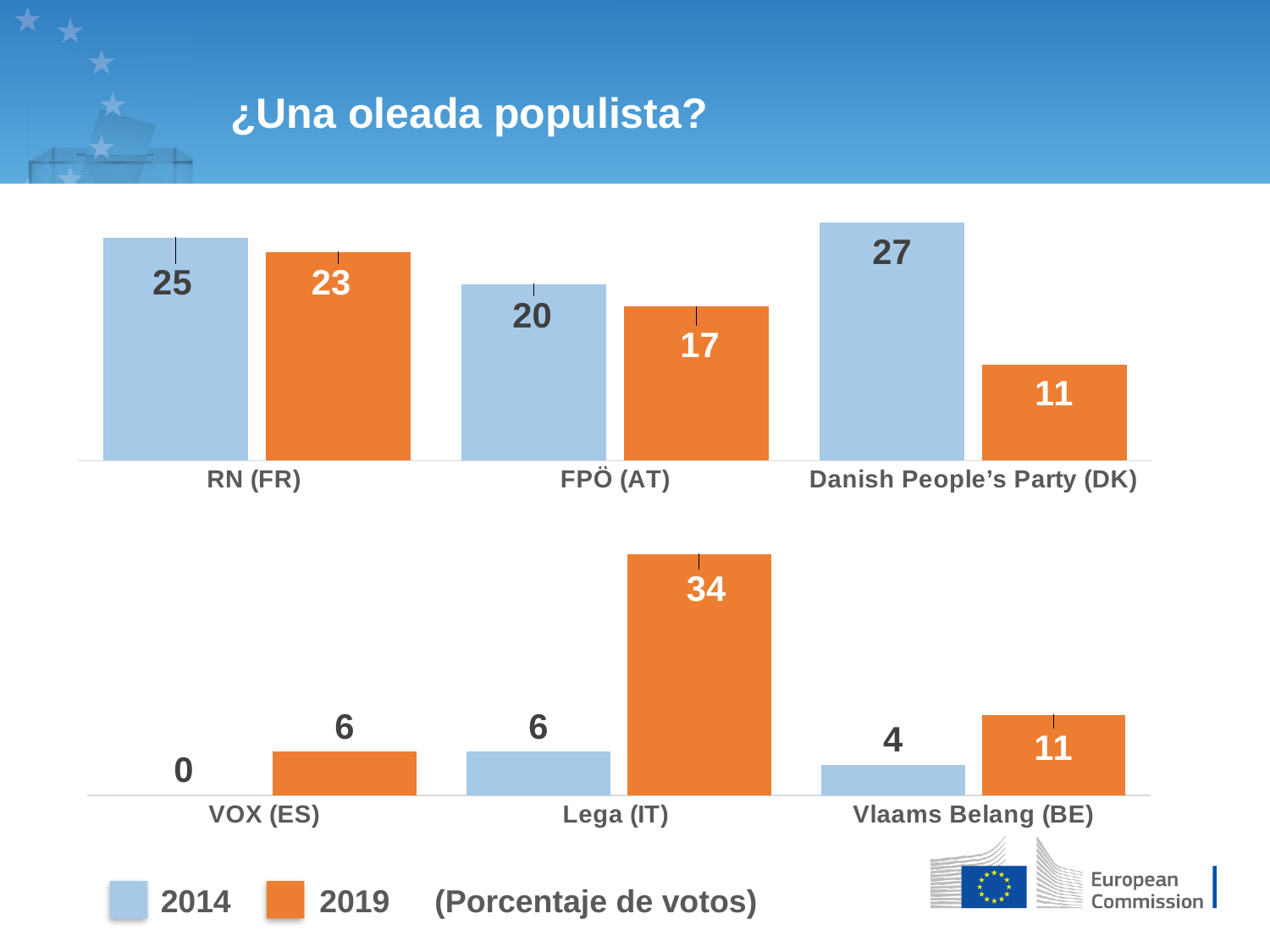
How many parties are shown in the bottom chart? 3 In the bottom chart, what is the 2014 value for VOX (ES)? 0 In the bottom chart, what is the 2019 value for Lega (IT)? 34 In the top chart, what is the difference between the 2014 and 2019 values for Danish People's Party (DK)? 16 In the bottom chart, which party has the lowest 2019 value? VOX (ES) In the top chart, what is the 2014 value for RN (FR)? 25 In the top chart, which party has the highest 2014 value? Danish People's Party (DK) In the bottom chart, what is the difference between the 2019 and 2014 values for Lega (IT)? 28 How many series does the legend list? 2 In the top chart, what is the 2019 value for Danish People's Party (DK)? 11 What kind of chart is the top chart? Bar chart In the top chart, which is larger for FPÖ (AT): the 2014 value or the 2019 value? 2014